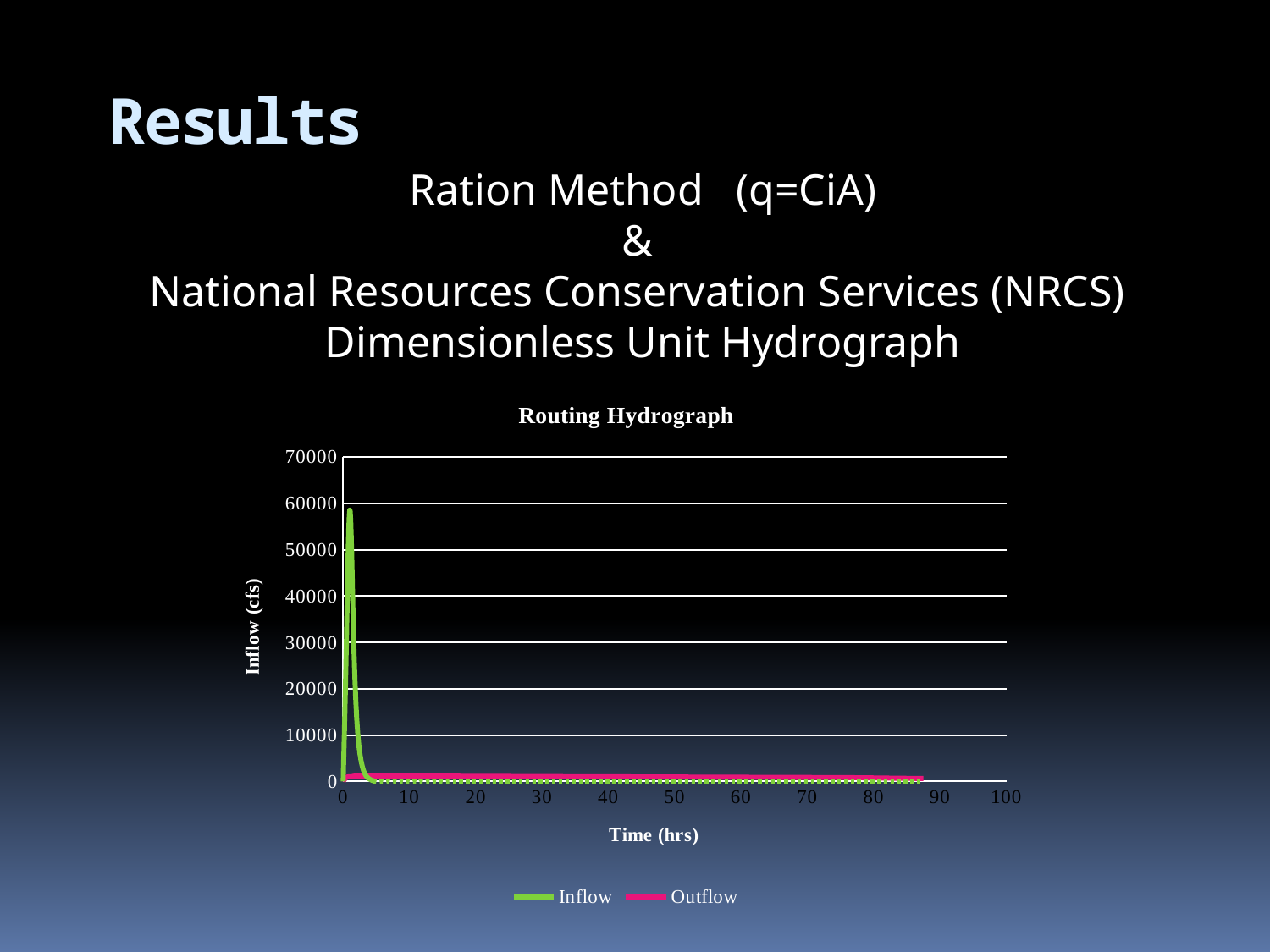
What kind of chart is shown on the slide? line chart What is the title of the chart on the slide? Routing Hydrograph How many series does the legend of the Routing Hydrograph chart list? 2 Is the Outflow series ever greater or less than 10000 cfs? less Is the peak of the Inflow series greater or less than 40000? greater What is the label of the x axis of the Routing Hydrograph chart? Time (hrs) Is the peak value of the Inflow series greater or less than 50000? greater After its peak, does the Inflow series rise or fall as time increases? fall Which series has the lowest peak value in the Routing Hydrograph chart? Outflow Which series reaches the higher peak value, Inflow or Outflow? Inflow